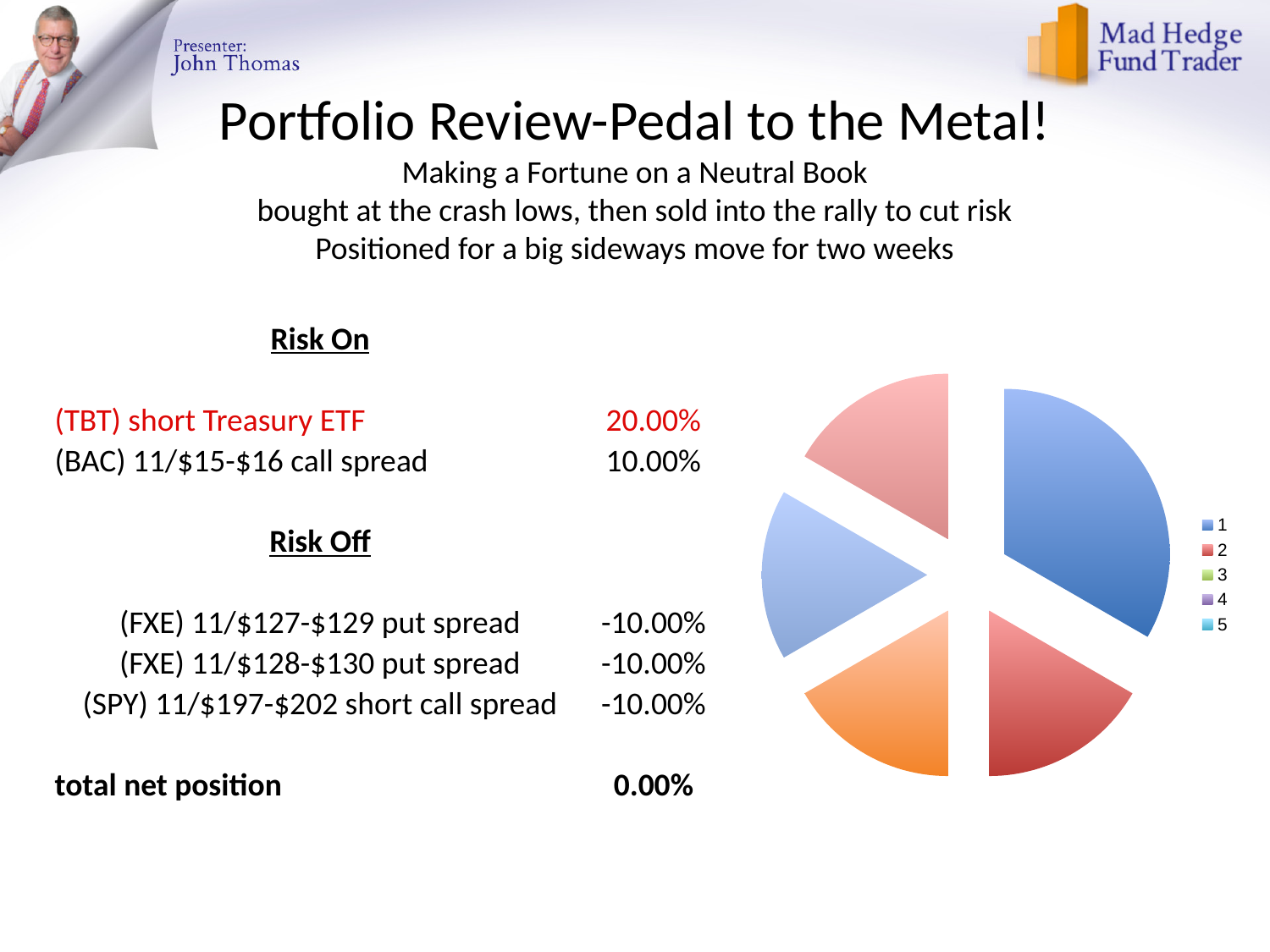
Which legend entry corresponds to the largest slice of the pie chart? 1 Which slice is larger in the pie chart, slice 1 or slice 2? 1 How many slices does the pie chart have? 5 What kind of chart is shown on the slide? pie chart What colour is the largest slice of the pie chart? blue How many entries does the legend of the pie chart list? 5 What are the labels listed in the legend of the pie chart? 1, 2, 3, 4, 5